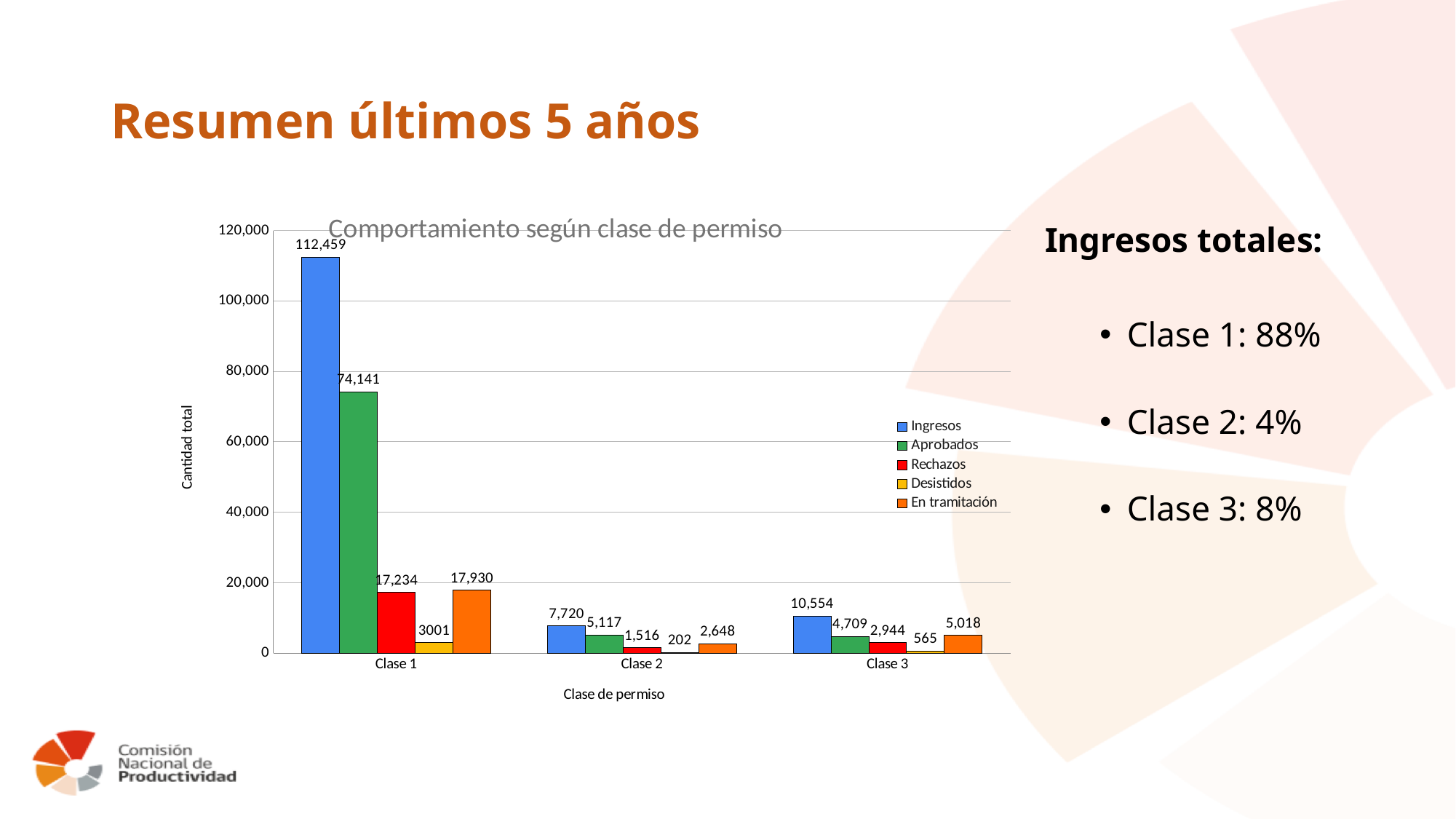
Which is larger for Clase 3: Rechazos or En tramitación? En tramitación What is the value of Aprobados for Clase 3? 4,709 What is the value of Desistidos for Clase 2? 202 How many series does the legend list? 5 What is the difference between Ingresos and Aprobados for Clase 1? 38,318 How many categories are shown on the x axis? 3 Is the Aprobados value for Clase 1 greater or less than 80,000? less Which category has the highest Ingresos value? Clase 1 Which category has the lowest Rechazos value? Clase 2 What kind of chart is shown on the slide? Bar chart What is the value of En tramitación for Clase 1? 17,930 What is the value of Ingresos for Clase 1? 112,459